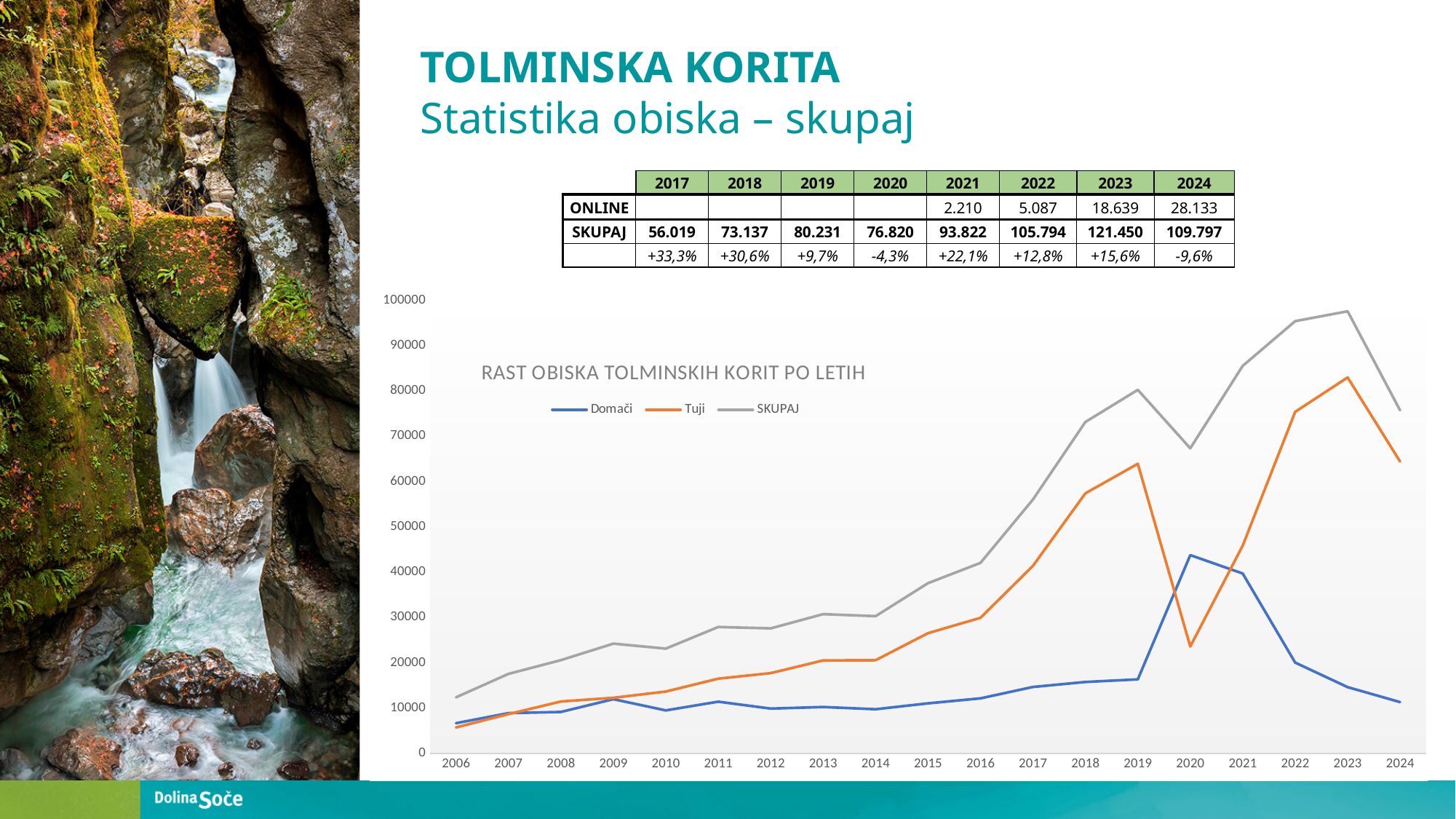
What is the title of the chart? RAST OBISKA TOLMINSKIH KORIT PO LETIH In 2020, which series has the larger value, Domači or Tuji? Domači What kind of chart is shown on the slide? Line chart In which year does the Domači line reach its highest value? 2020 Is the Domači value for 2020 greater or less than 40000? greater Is the SKUPAJ value for 2023 greater or less than 90000? greater In which year is the SKUPAJ line at its lowest value? 2006 How many years are plotted along the x axis of the chart? 19 How many series does the chart legend list? 3 Does the SKUPAJ line rise or fall from 2023 to 2024? Fall Is the Tuji value for 2020 greater or less than 30000? less In which year does the SKUPAJ line reach its highest value? 2023